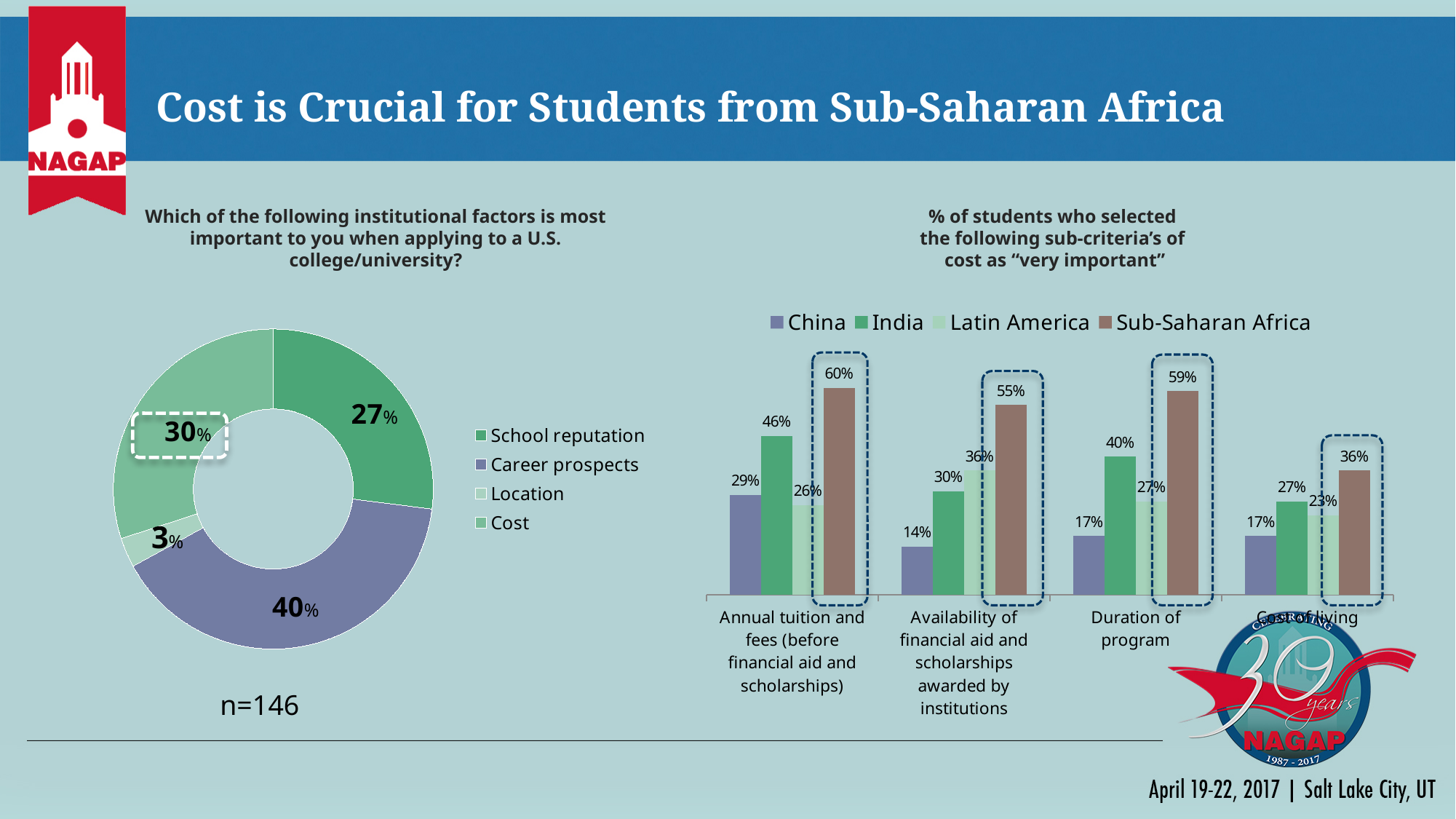
In the donut chart on the left, what percentage of students selected Career prospects as the most important institutional factor? 40% In the bar chart on the right, what percentage of students from China selected Availability of financial aid and scholarships as very important? 14% In the bar chart on the right, what percentage of students from Sub-Saharan Africa selected Annual tuition and fees as very important? 60% In the donut chart on the left, which institutional factor has the largest share? Career prospects How many categories does the donut chart on the left show? 4 In the bar chart on the right, which is larger for Cost of living: India or Latin America? India In the donut chart on the left, what is the difference in percentage points between Cost and School reputation? 3 What type of chart is shown on the right side of the slide? Bar chart How many series does the legend of the bar chart on the right list? 4 In the donut chart on the left, which institutional factor has the smallest share? Location In the bar chart on the right, which region has the highest value for Duration of program? Sub-Saharan Africa In the bar chart on the right, what is the difference in percentage points between Sub-Saharan Africa and India for Duration of program? 19